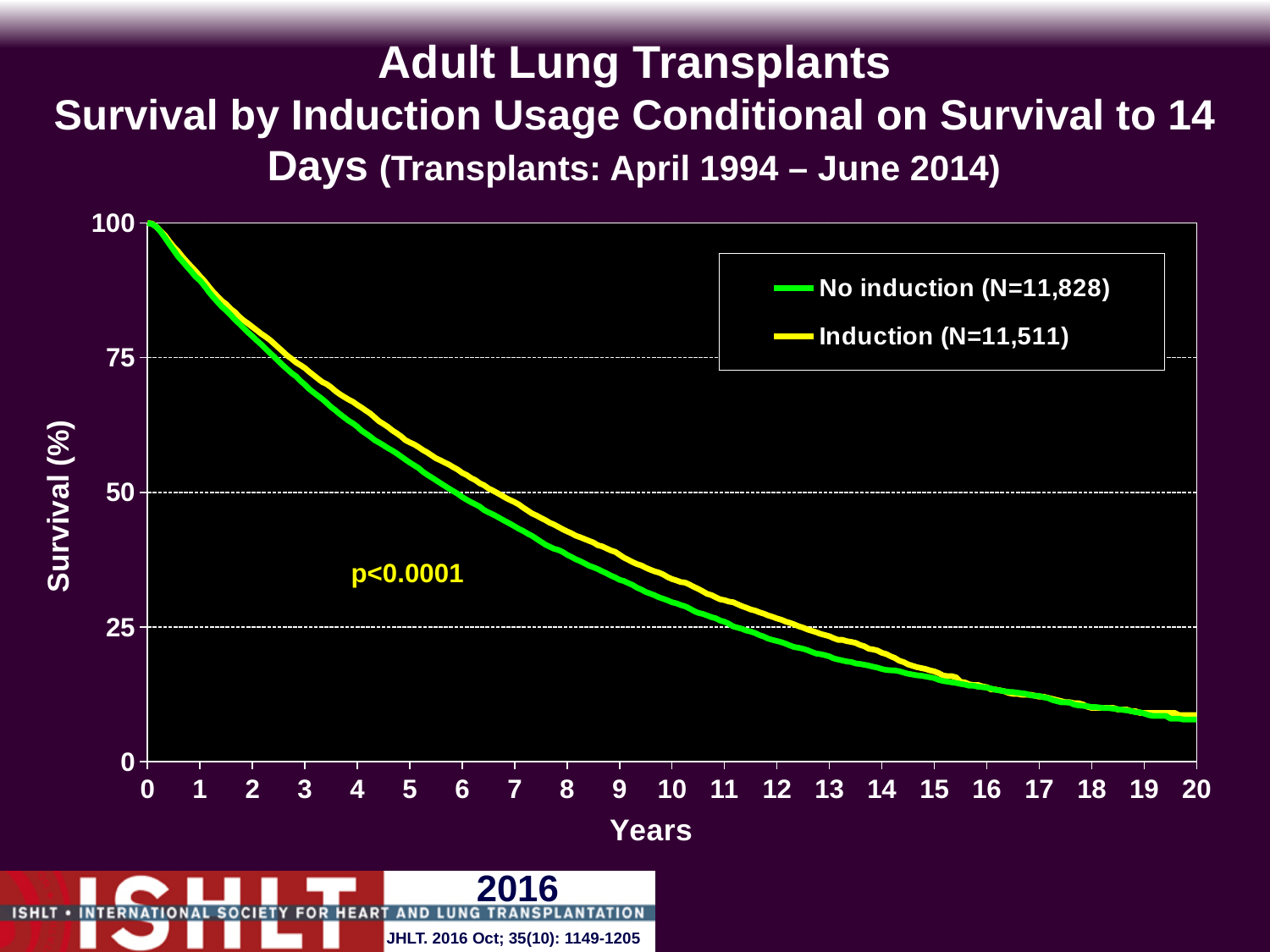
Is the survival value for No induction at year 2 greater or less than 75? greater Is the survival value for Induction at year 15 greater or less than 25? less How many series does the legend list? 2 What p-value is printed on the chart? p<0.0001 What is the highest value shown on the Years axis? 20 What is the survival value for both groups at year 0? 100 At year 8, which group has the higher survival, Induction or No induction? Induction What is the N for the No induction group shown in the legend? 11,828 Is the survival value for No induction at year 5 greater or less than 50? greater Which series is drawn in yellow? Induction (N=11,511) Do the survival curves rise or fall as years increase? fall What kind of chart is shown on the slide? line chart